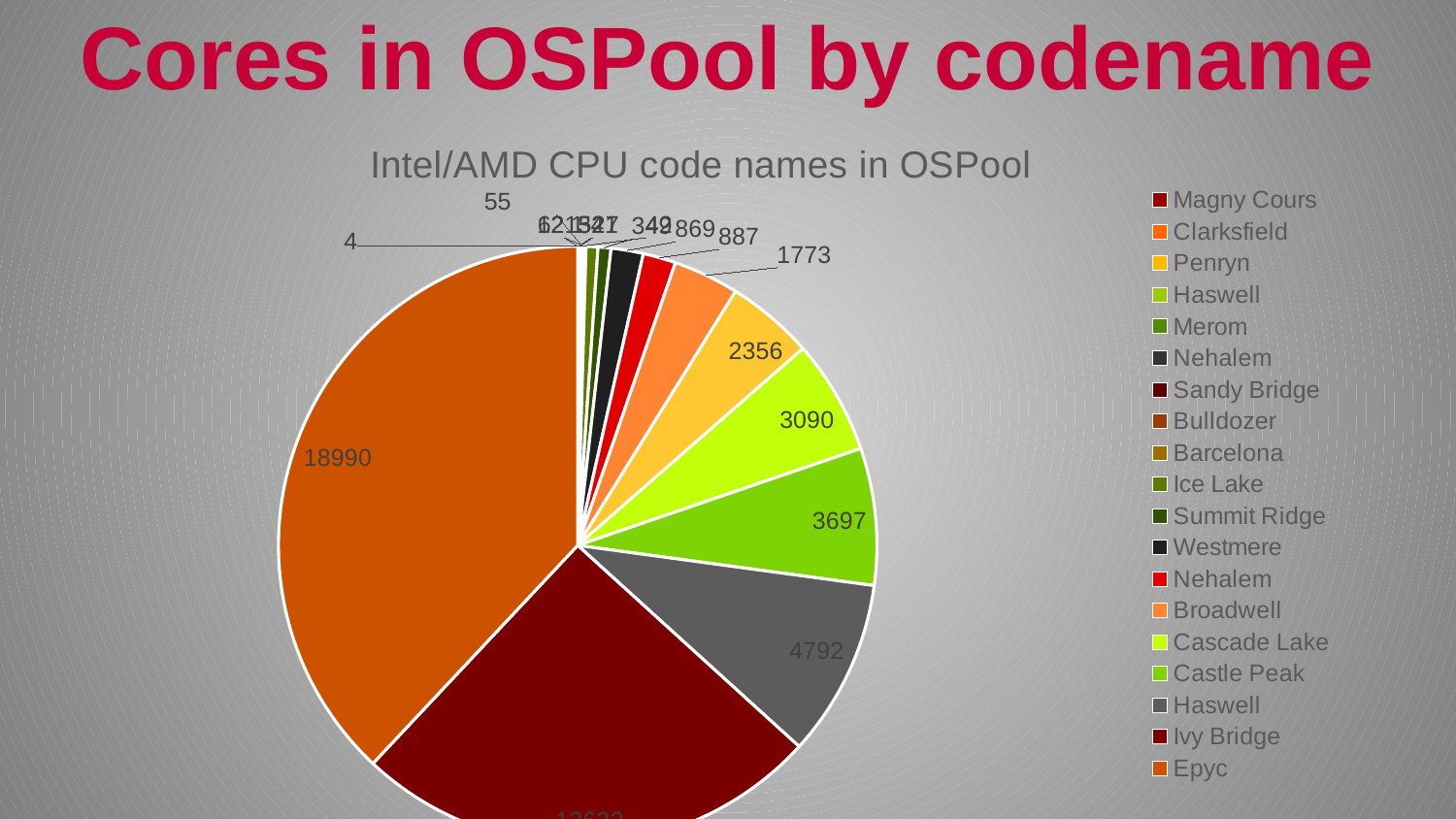
How many times does the codename Haswell appear in the legend? 2 What is the difference between the slices labelled 3697 and 3090? 607 Which is larger, the slice labelled 4792 or the slice labelled 3697? 4792 How many cores are shown for Epyc? 18990 What is the difference between the slices labelled 4792 and 3697? 1095 Which is larger, the slice labelled 887 or the slice labelled 1773? 1773 What is the title of the chart? Intel/AMD CPU code names in OSPool What type of chart is shown on the slide? pie chart What is the value of the largest slice in the pie chart? 18990 What is the difference between the slices labelled 2356 and 1773? 583 How many entries does the chart legend list? 19